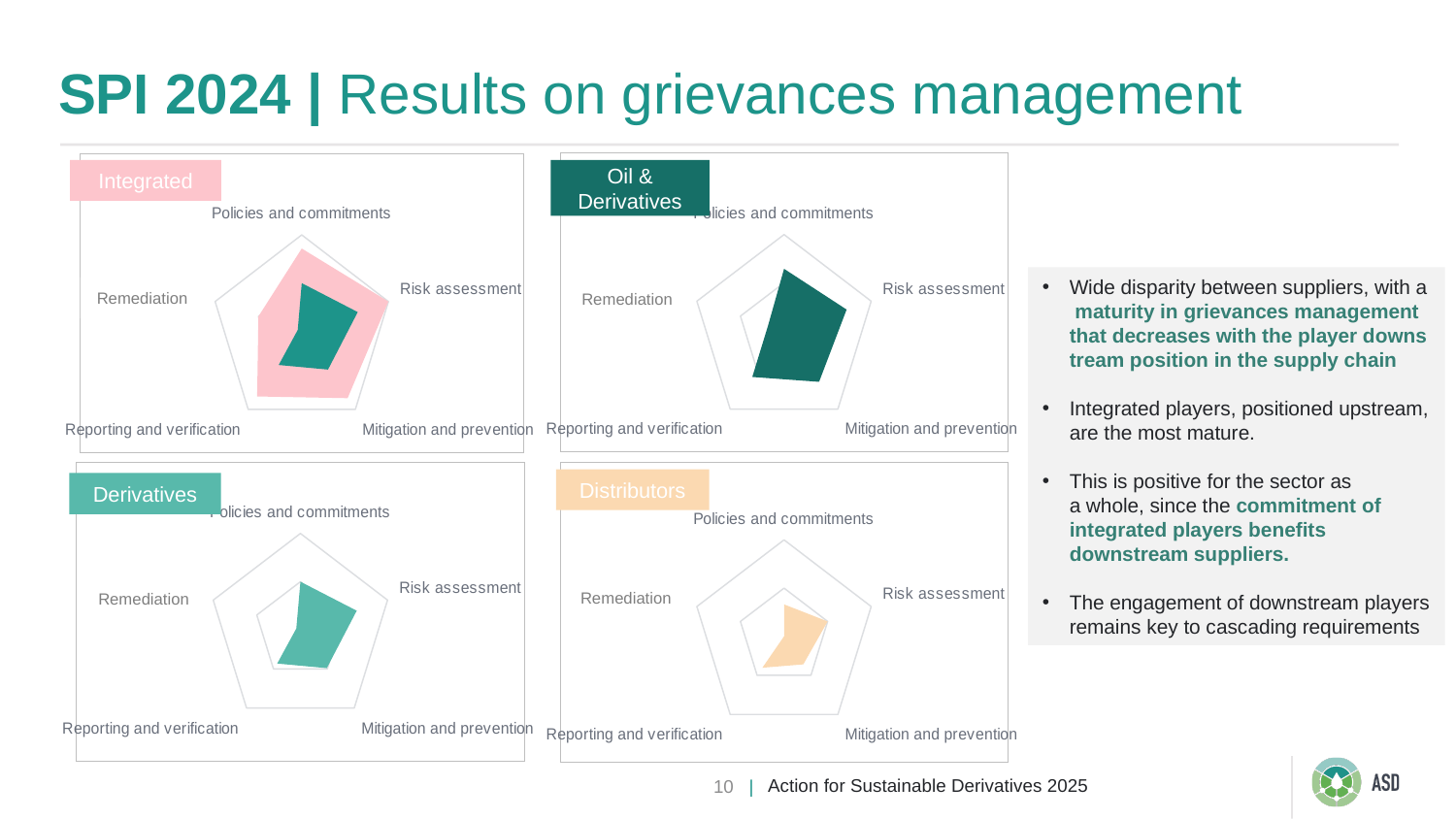
How many categories (axes) does the Distributors radar chart have? 5 Which category label appears at the top of each radar chart? Policies and commitments How many data series are plotted in the Oil & Derivatives radar chart? 1 In the Distributors chart, which is larger: Risk assessment or Remediation? Risk assessment What kind of chart is used for the Integrated group? Radar chart What colour is the filled series in the Distributors radar chart? Light orange (peach) How many radar charts are shown on the slide? 4 In the Derivatives chart, which category has the lowest value? Remediation In the Oil & Derivatives chart, which category has the lowest value? Remediation In the Distributors chart, which category has the lowest value? Remediation In the Oil & Derivatives chart, which is larger: Mitigation and prevention or Remediation? Mitigation and prevention